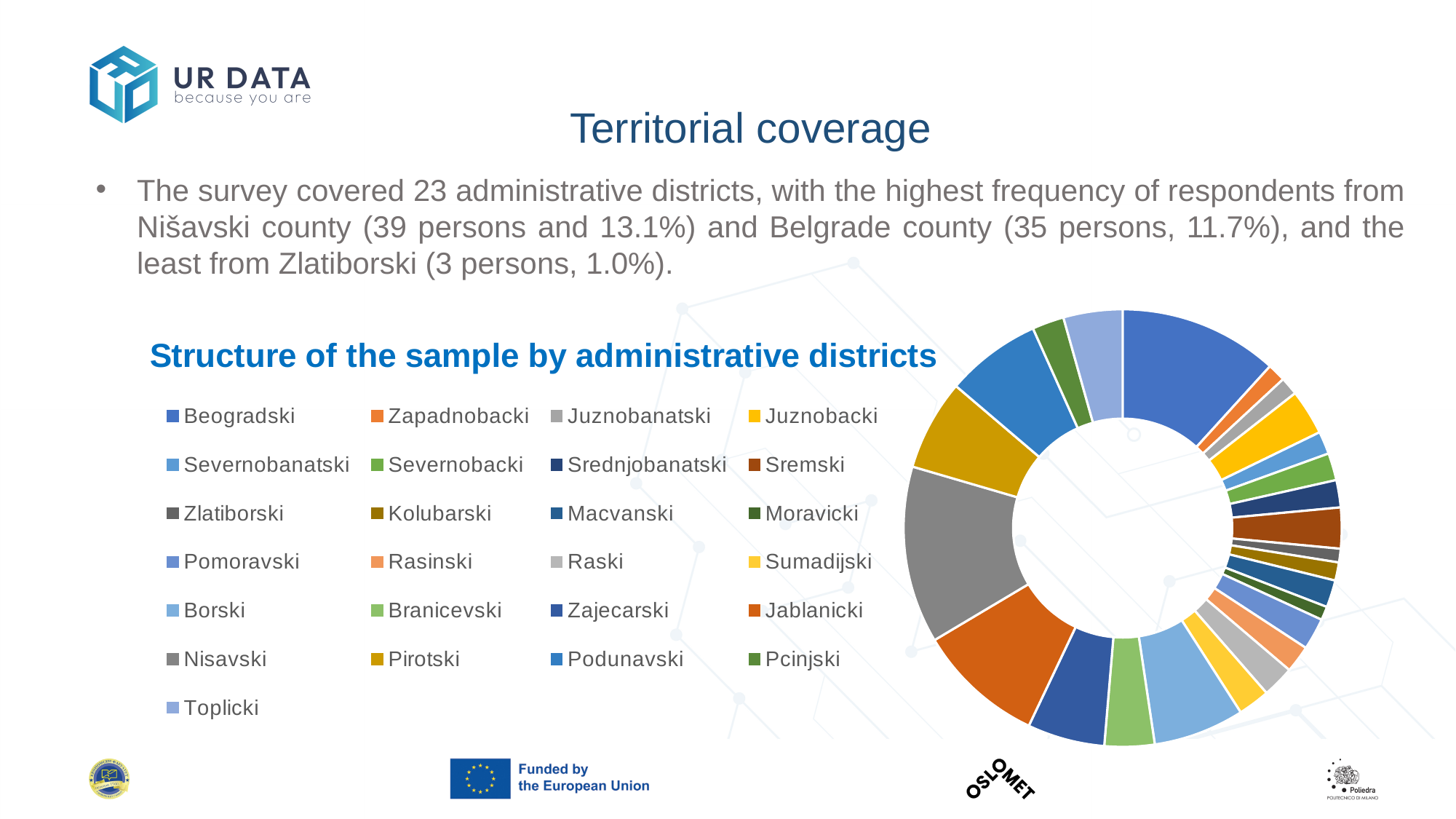
What is the title of the chart? Structure of the sample by administrative districts What kind of chart is shown on the slide? Pie (doughnut) chart How many districts does the chart legend list? 25 Which is larger, the slice for Nisavski or the slice for Beogradski? Nisavski Which district has the smallest share of respondents? Zlatiborski What share of the sample comes from Nisavski county? 13.1% Which is larger, the slice for Pirotski or the slice for Pcinjski? Pirotski What colour represents Nisavski in the chart? Gray Which district has the largest slice in the chart? Nisavski Which is larger, the slice for Jablanicki or the slice for Zapadnobacki? Jablanicki What share of the sample comes from Belgrade (Beogradski) county? 11.7%